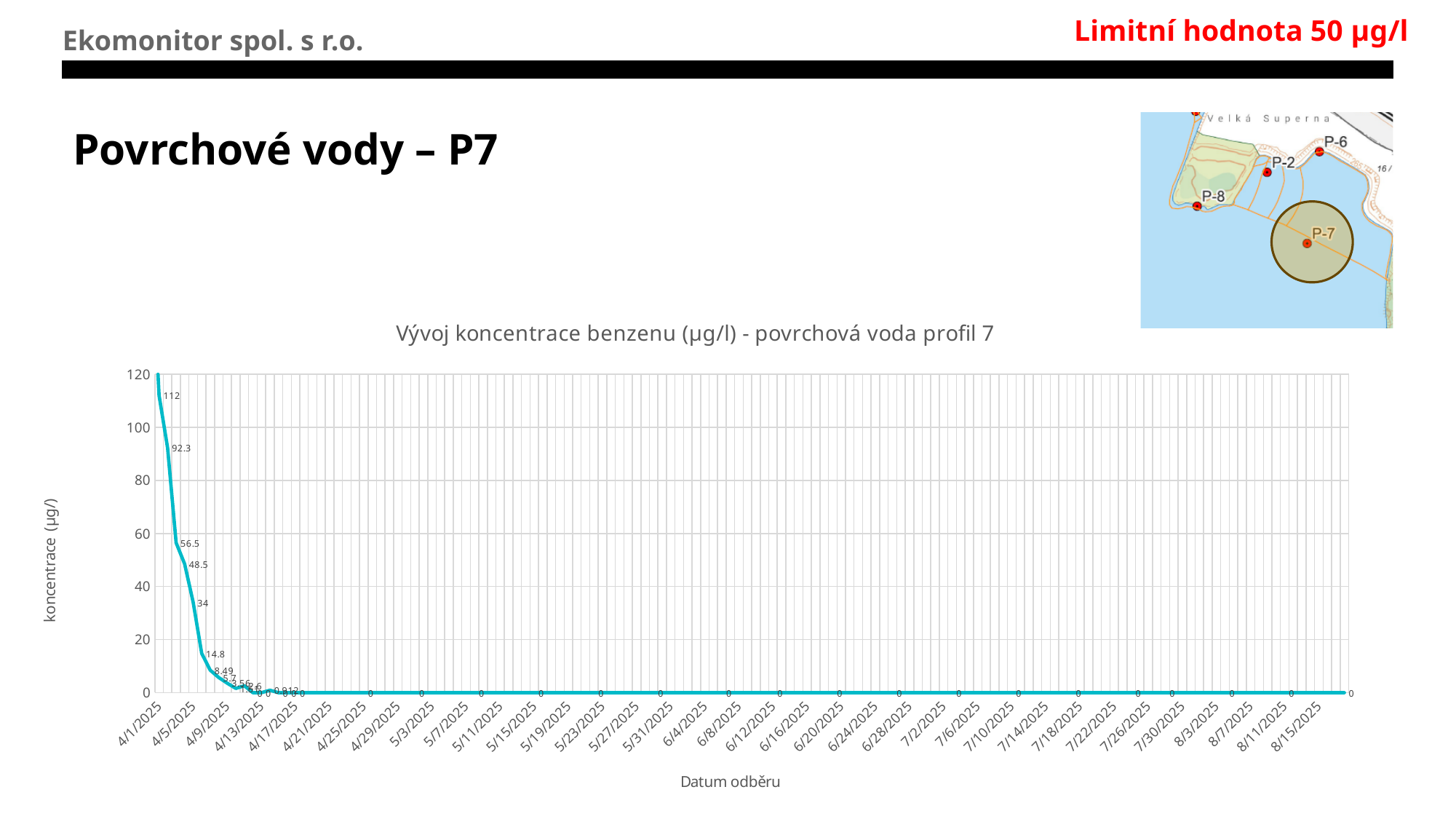
What is the difference between the data labels 112 and 92.3 on the chart? 19.7 What is the title of the chart? Vývoj koncentrace benzenu (µg/l) - povrchová voda profil 7 What is the value plotted for 6/4/2025? 0 What is the highest tick value shown on the y axis? 120 What is the value plotted for 8/15/2025? 0 What is the label of the y axis of the chart? koncentrace (µg/l) How many date labels are shown on the x axis? 35 Do the benzene concentration values rise or fall along the x axis over time? fall What kind of chart is shown on the slide? line chart Which is larger, the data point labelled 92.3 or the one labelled 56.5? 92.3 Is the value for 7/2/2025 greater or less than 20? less What is the difference between the data labels 56.5 and 48.5 on the chart? 8